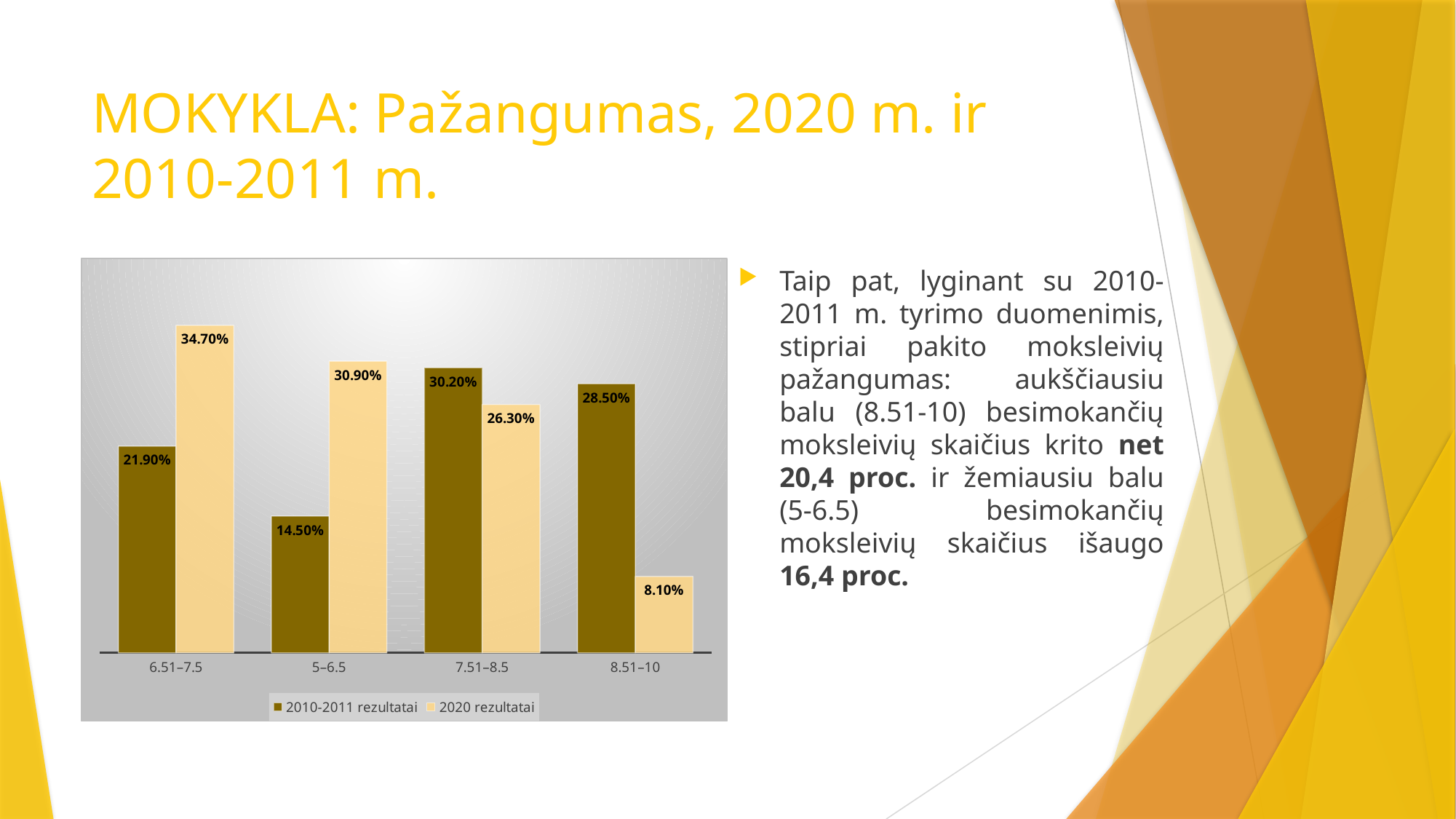
What is the difference between the 2020 rezultatai and 2010-2011 rezultatai values in the 8.51–10 category? 20.40% What is the value for 2020 rezultatai in the 8.51–10 category? 8.10% In the 7.51–8.5 category, which series has the larger value: 2010-2011 rezultatai or 2020 rezultatai? 2010-2011 rezultatai What is the value for 2010-2011 rezultatai in the 5–6.5 category? 14.50% How many series does the chart legend list? 2 Which category has the lowest value for 2020 rezultatai? 8.51–10 What is the value for 2010-2011 rezultatai in the 7.51–8.5 category? 30.20% Which category has the highest value for 2010-2011 rezultatai? 7.51–8.5 What is the difference between the 2020 rezultatai and 2010-2011 rezultatai values in the 5–6.5 category? 16.40% What is the value for 2020 rezultatai in the 6.51–7.5 category? 34.70% How many categories are shown on the x axis of the chart? 4 What kind of chart is shown on the slide? Bar chart